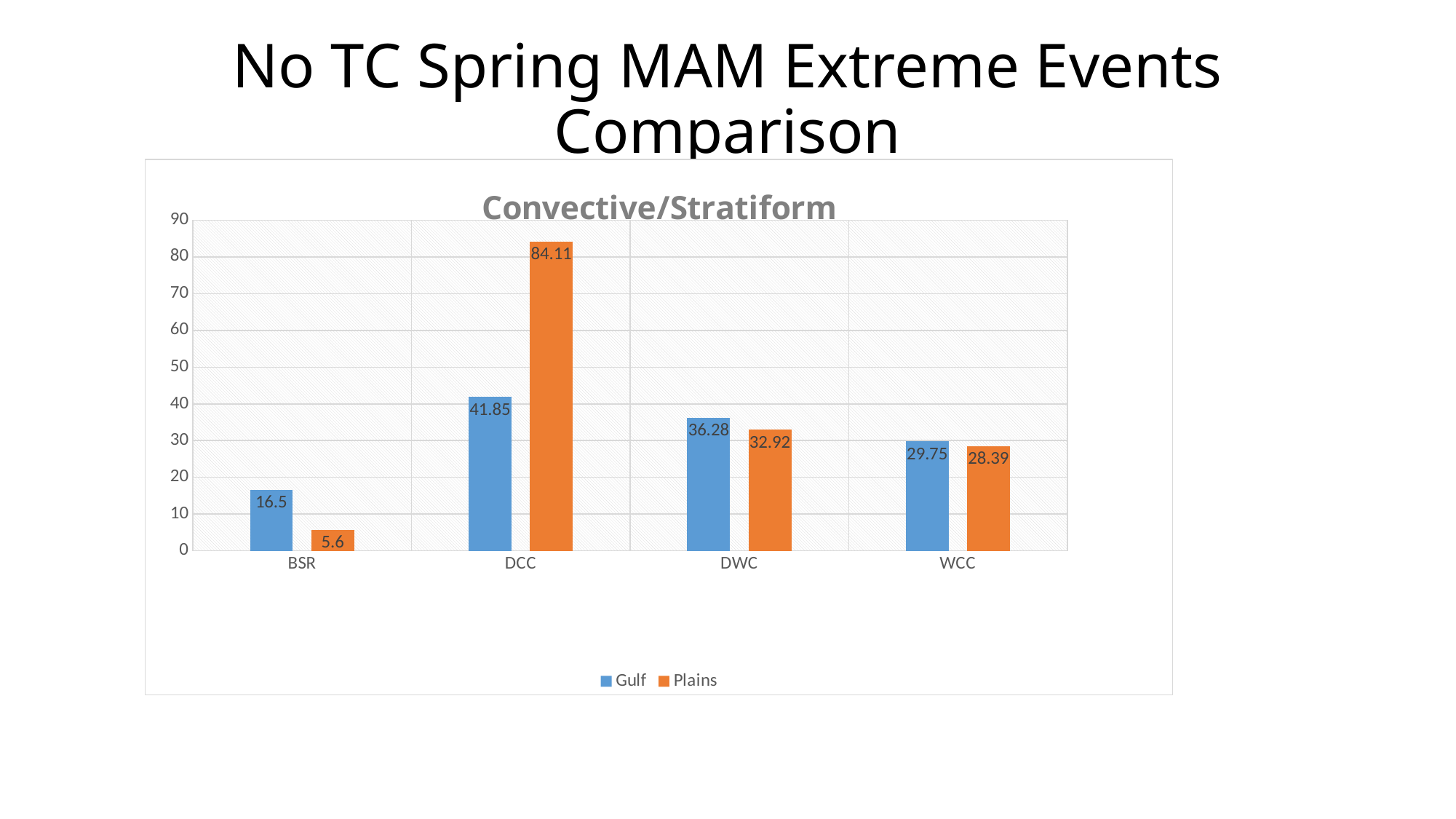
What is the title of the chart? Convective/Stratiform Which category has the lowest Gulf value? BSR What is the Plains value for BSR? 5.6 What is the Plains value for WCC? 28.39 What is the Gulf value for DCC? 41.85 What kind of chart is shown? bar chart How many categories are shown on the x axis? 4 What is the difference between the Plains and Gulf values for DCC? 42.26 Which is larger for BSR, the Gulf value or the Plains value? Gulf Which category has the highest Plains value? DCC Is the Plains value for DCC greater or less than 80? greater How many series does the legend list? 2